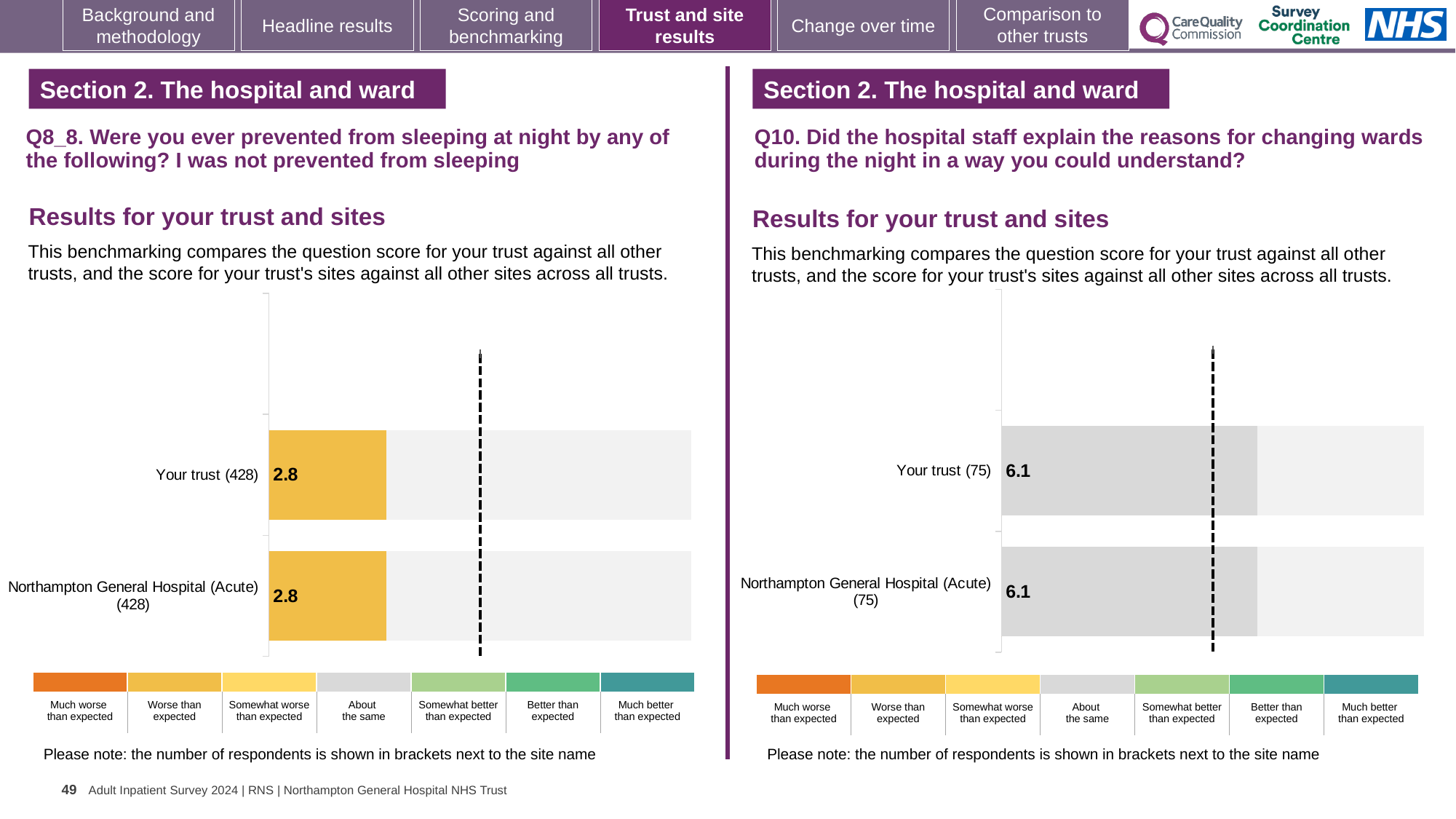
How many bars are plotted in the left chart (Q8_8)? 2 How many bars are plotted in the right chart (Q10)? 2 In the left chart (Q8_8), what is the score for Northampton General Hospital (Acute) (428)? 2.8 How many respondents are shown in brackets for Your trust in the right chart (Q10)? 75 What kind of chart is used in the left chart (Q8_8)? Bar chart In the right chart (Q10), what is the score for Northampton General Hospital (Acute) (75)? 6.1 In the left chart (Q8_8), which benchmark category does the colour of the bars correspond to according to the legend? Worse than expected In the left chart (Q8_8), what is the difference between the score for Your trust and the score for Northampton General Hospital (Acute)? 0.0 In the right chart (Q10), what is the score for Your trust (75)? 6.1 In the right chart (Q10), what is the difference between the score for Your trust and the score for Northampton General Hospital (Acute)? 0.0 Is the score for Your trust in the right chart (Q10) larger or smaller than the score for Your trust in the left chart (Q8_8)? Larger In the left chart (Q8_8), what is the score for Your trust (428)? 2.8